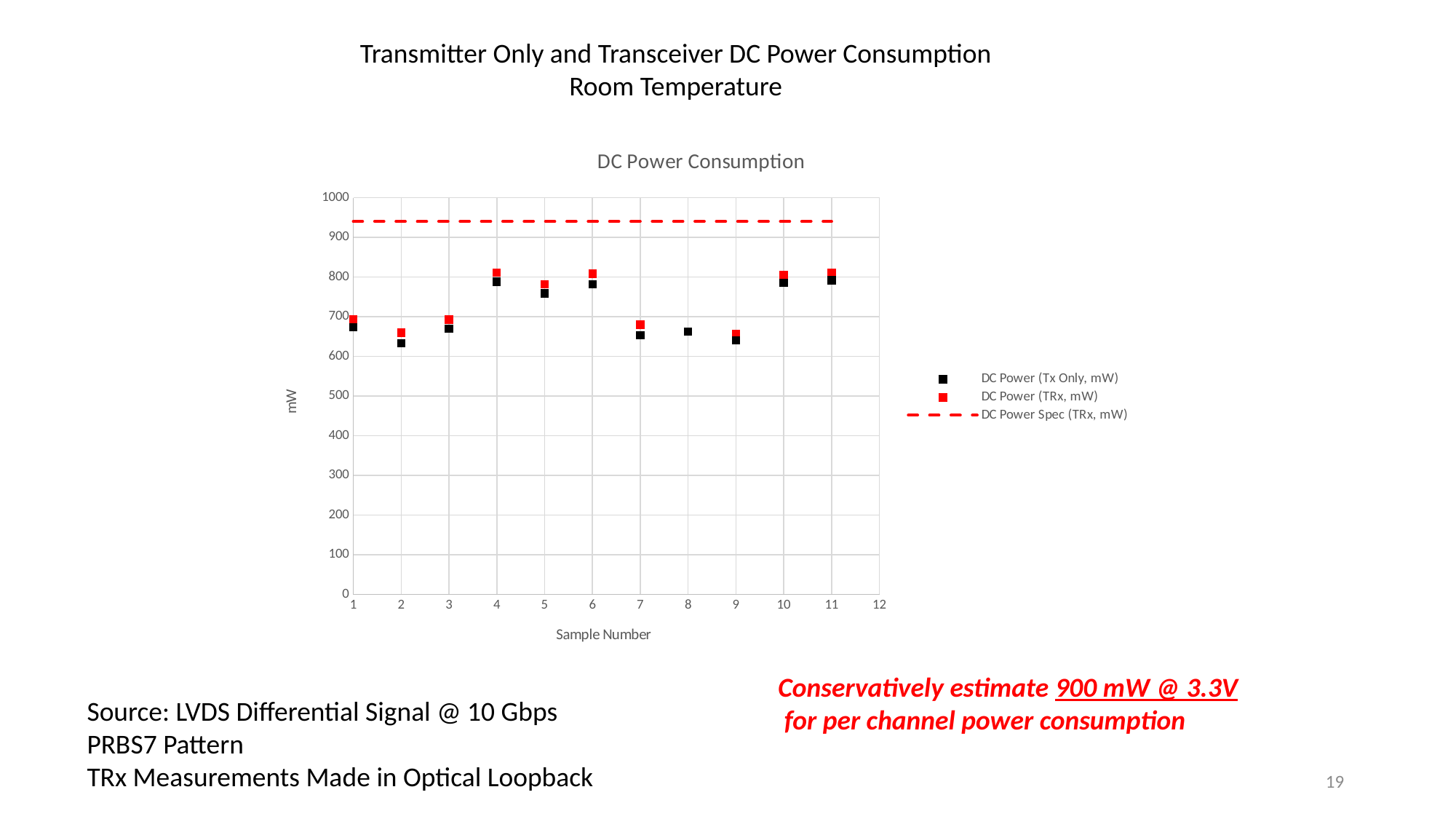
Is the DC Power (Tx Only, mW) value for sample 2 greater or less than 700? less What is the label on the y axis of the chart? mW Is the DC Power Spec (TRx, mW) dashed line greater or less than 1000? less Is the DC Power (TRx, mW) value for sample 4 greater or less than 900? less How many series does the legend list? 3 How many sample numbers have DC Power (Tx Only, mW) points plotted? 11 What colour are the DC Power (TRx, mW) markers? Red What kind of chart is shown on the slide? Scatter chart At sample 4, which is larger: DC Power (Tx Only, mW) or DC Power (TRx, mW)? DC Power (TRx, mW) Does the DC Power Spec (TRx, mW) line rise, fall, or stay flat across the sample numbers? Stay flat